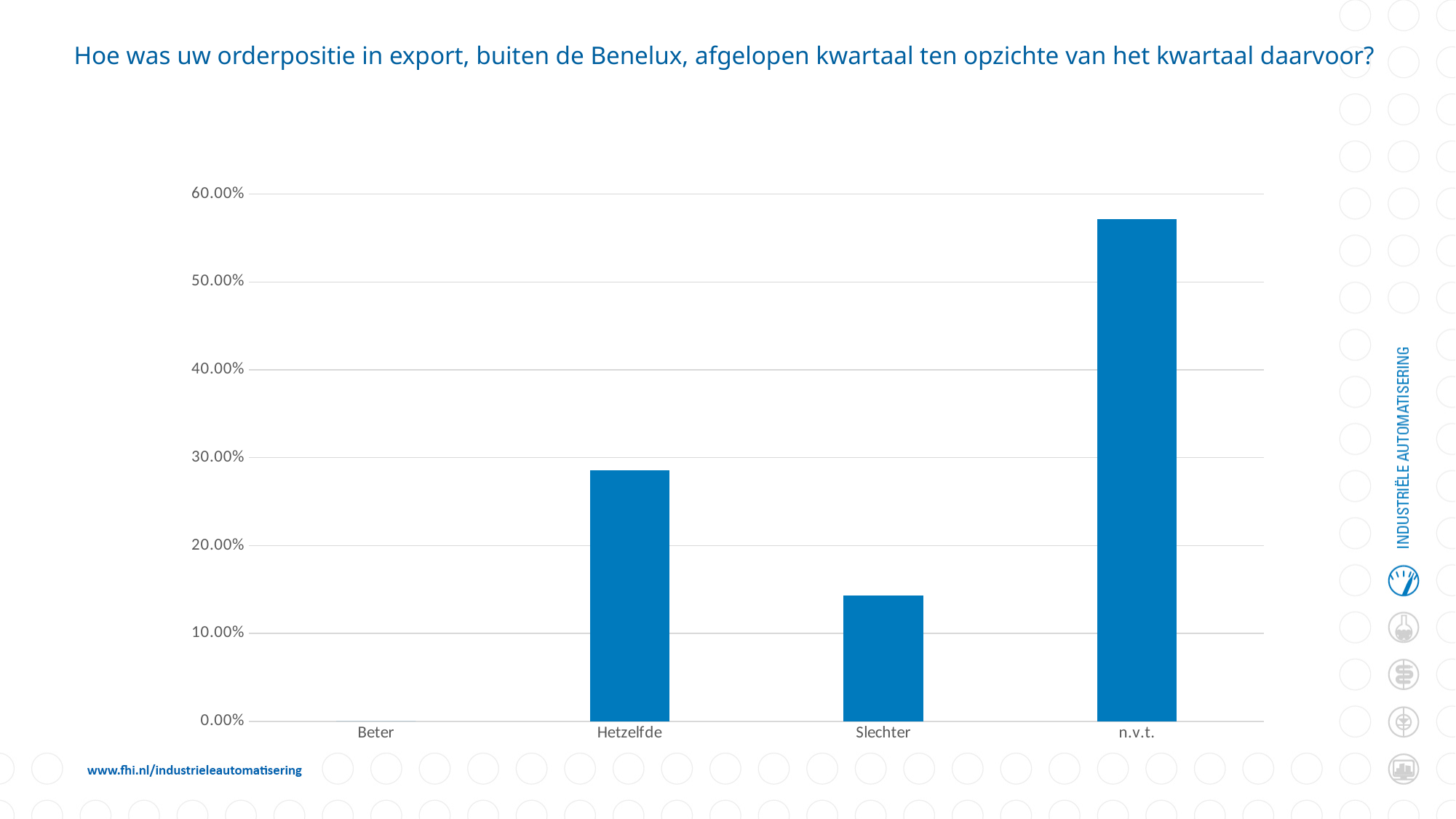
Which category has the lowest value in the chart? Beter Which is larger, the value for Hetzelfde or the value for Slechter? Hetzelfde How many categories are shown on the x axis of the chart? 4 Is the value for Hetzelfde greater or less than 30.00%? less What is the value for Beter? 0.00% What is the title of the chart on the slide? Hoe was uw orderpositie in export, buiten de Benelux, afgelopen kwartaal ten opzichte van het kwartaal daarvoor? Which category has the highest value in the chart? n.v.t. Is the value for Slechter greater or less than 10.00%? greater Is the value for n.v.t. greater or less than 50.00%? greater Which is larger, the value for n.v.t. or the value for Hetzelfde? n.v.t. What kind of chart is shown on the slide? bar chart